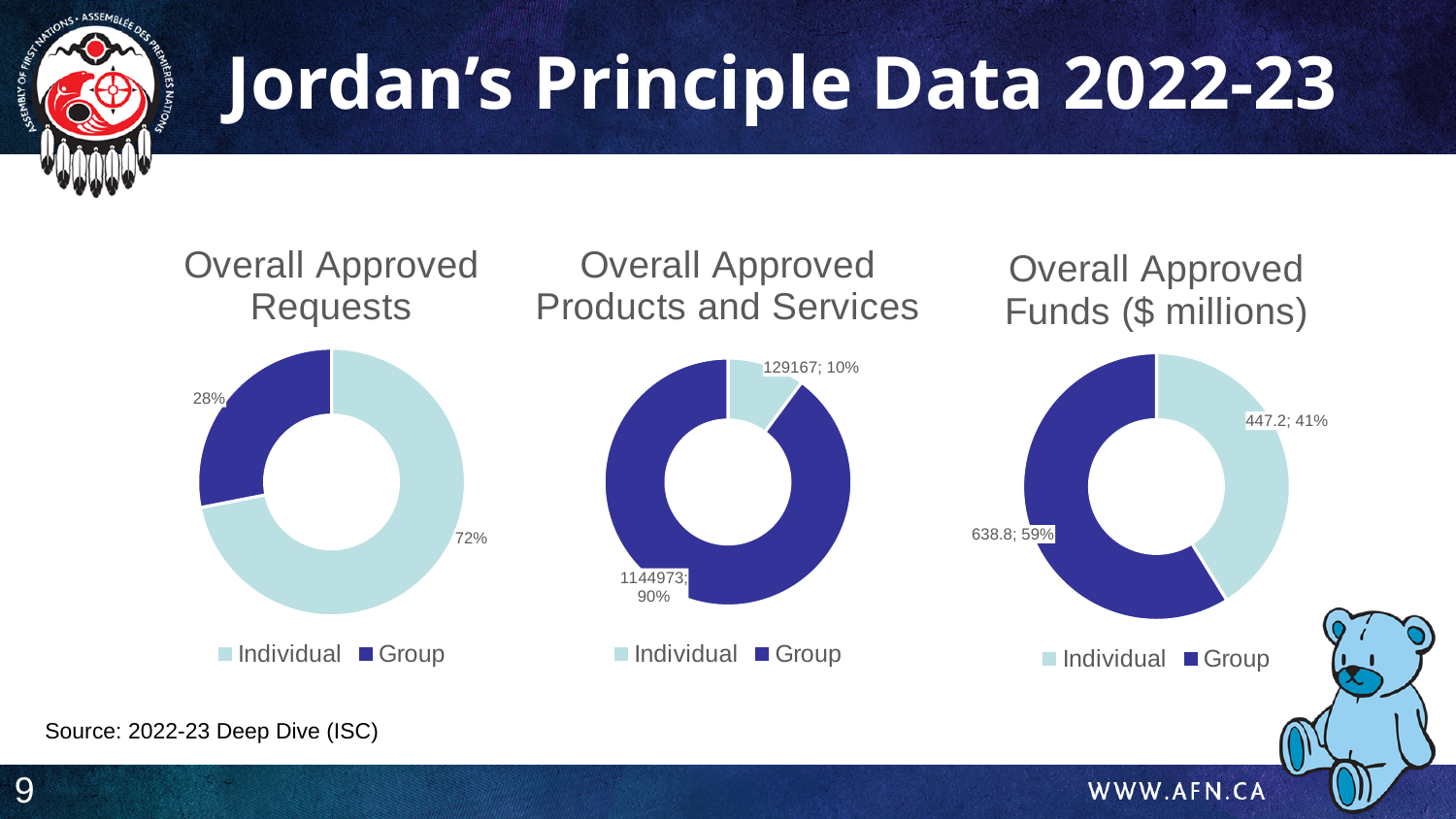
In the 'Overall Approved Funds ($ millions)' chart, what is the difference between the Group and Individual values? 191.6 In the 'Overall Approved Products and Services' chart, what percentage share does Group have? 90% In the 'Overall Approved Requests' chart, which category has the larger share? Individual In the 'Overall Approved Funds ($ millions)' chart, what is the value for Individual? 447.2 In the 'Overall Approved Requests' chart, what share of requests is Individual? 72% In the 'Overall Approved Products and Services' chart, what is the value for Group? 1144973 How many categories does the legend of the 'Overall Approved Funds ($ millions)' chart list? 2 What kind of chart is the 'Overall Approved Requests' chart? Doughnut (pie) chart In the 'Overall Approved Funds ($ millions)' chart, what is the value for Group? 638.8 In the 'Overall Approved Products and Services' chart, which category is smaller? Individual In the 'Overall Approved Requests' chart, what share of requests is Group? 28% In the 'Overall Approved Products and Services' chart, what is the value for Individual? 129167